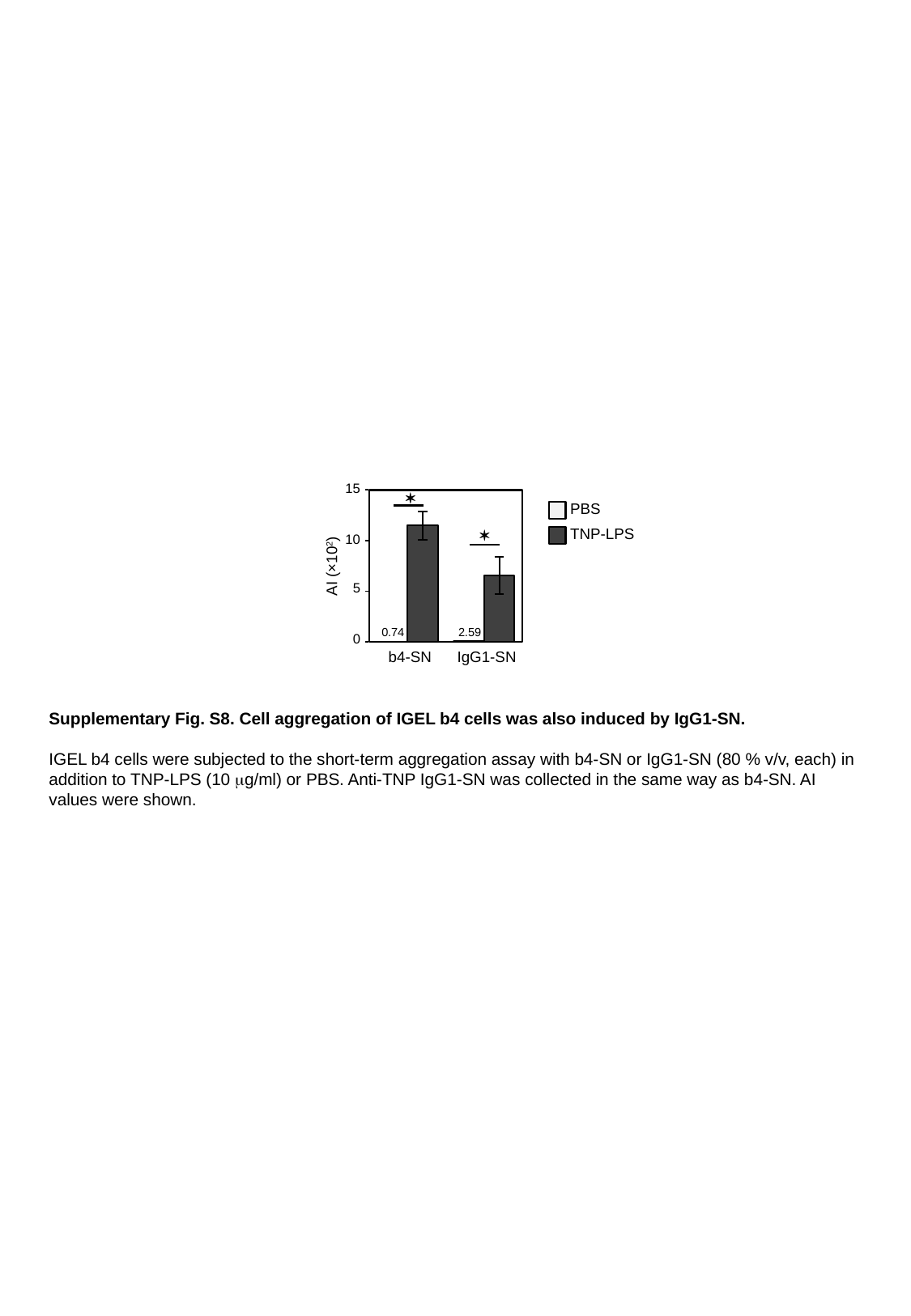
What is the label of the y axis? AI (×10²) Which has the larger PBS value, b4-SN or IgG1-SN? IgG1-SN What is the PBS value for b4-SN? 0.74 Is the TNP-LPS value for IgG1-SN greater or less than 5? greater What kind of chart is shown? bar chart Which category has the highest TNP-LPS value? b4-SN How many series does the legend list? 2 What is the PBS value for IgG1-SN? 2.59 How many categories are shown on the x axis? 2 Is the TNP-LPS value for b4-SN greater or less than 10? greater Is the TNP-LPS value for IgG1-SN greater or less than 10? less What is the difference between the PBS values for IgG1-SN and b4-SN? 1.85